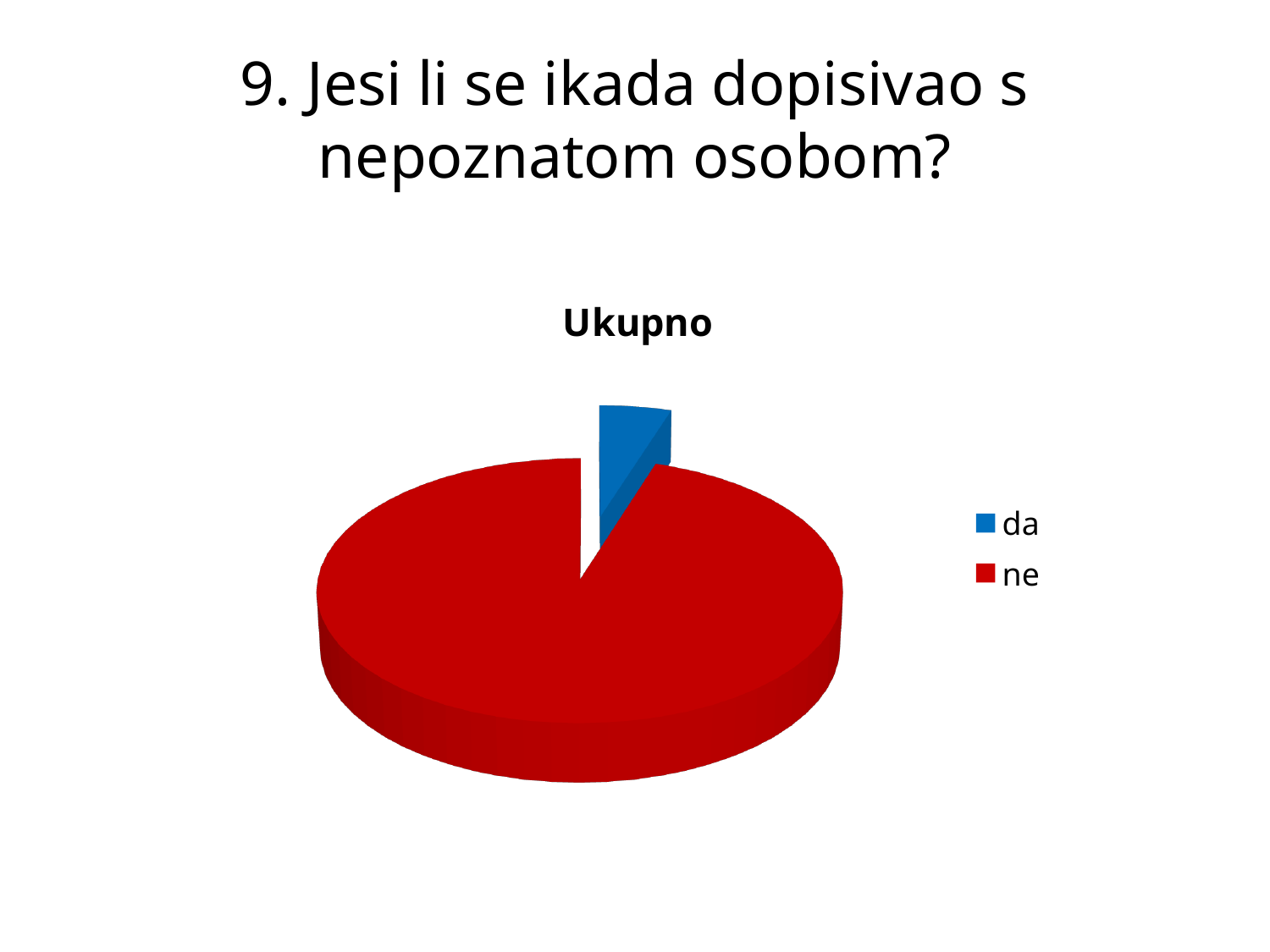
What colour is the slice for "ne"? red Which category has the smallest slice of the pie? da What is the title of the chart? Ukupno What kind of chart is shown on the slide? pie chart How many categories does the legend list? 2 How many slices does the pie chart have? 2 Which category has the largest slice of the pie? ne Which slice is larger, "da" or "ne"? ne